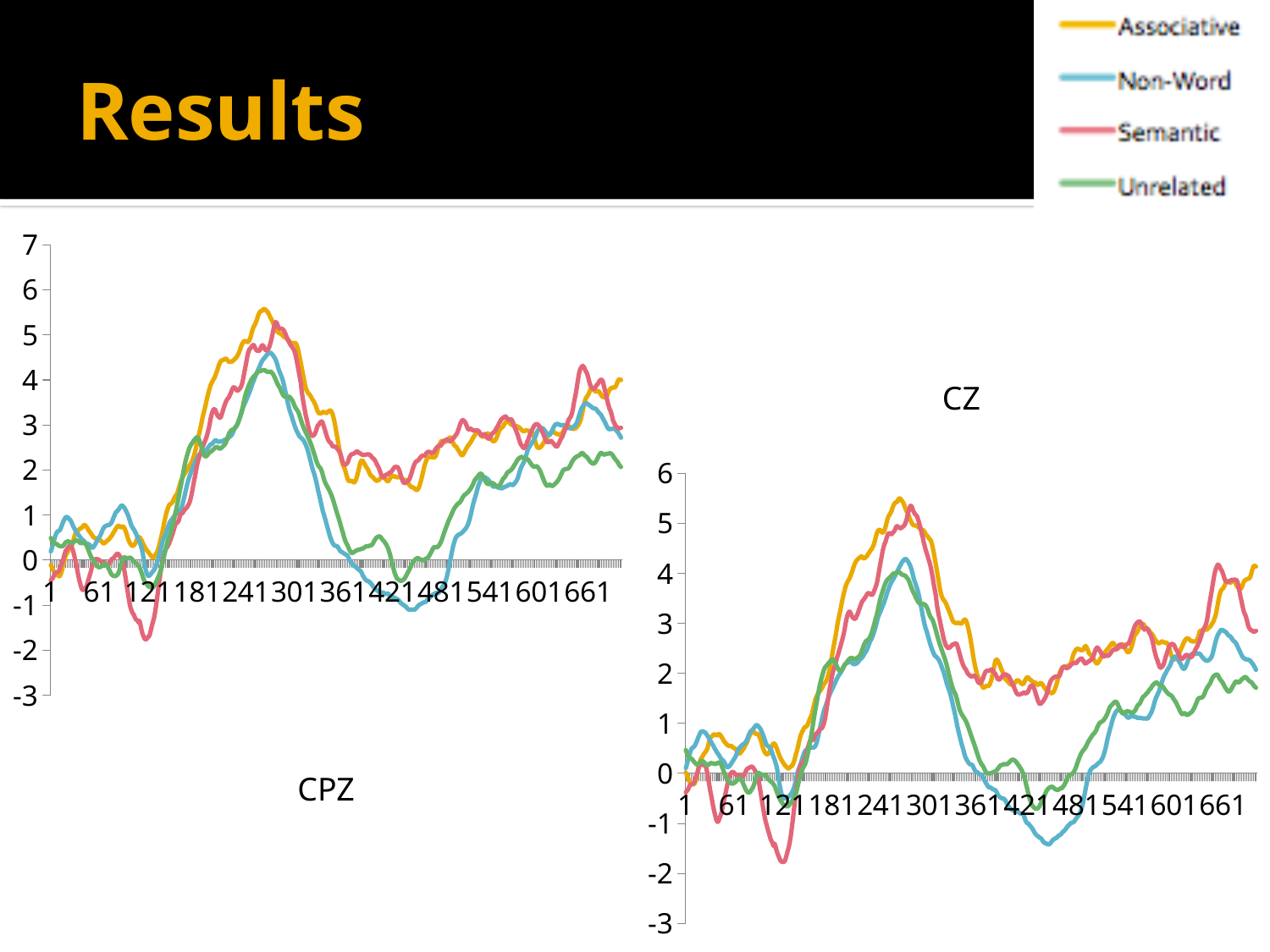
What kind of chart is the CPZ chart on the left? line chart In the CZ chart, is the lowest value of the Non-Word series greater or less than -1? less How many series does the legend list? 4 Which series is shown in green in the legend? Unrelated In the CZ chart, which series reaches the lowest value? Semantic In the CPZ chart, which series reaches the highest peak? Associative What is the highest value shown on the y axis of the CPZ chart? 7 In the CPZ chart, is the lowest value of the Semantic series near x = 121 greater or less than -1? less In the CZ chart, around x = 421, is the Associative series higher or lower than the Non-Word series? higher How many labelled tick values are shown on the x axis of the CZ chart? 12 In the CZ chart, is the peak value of the Unrelated series greater or less than 5? less